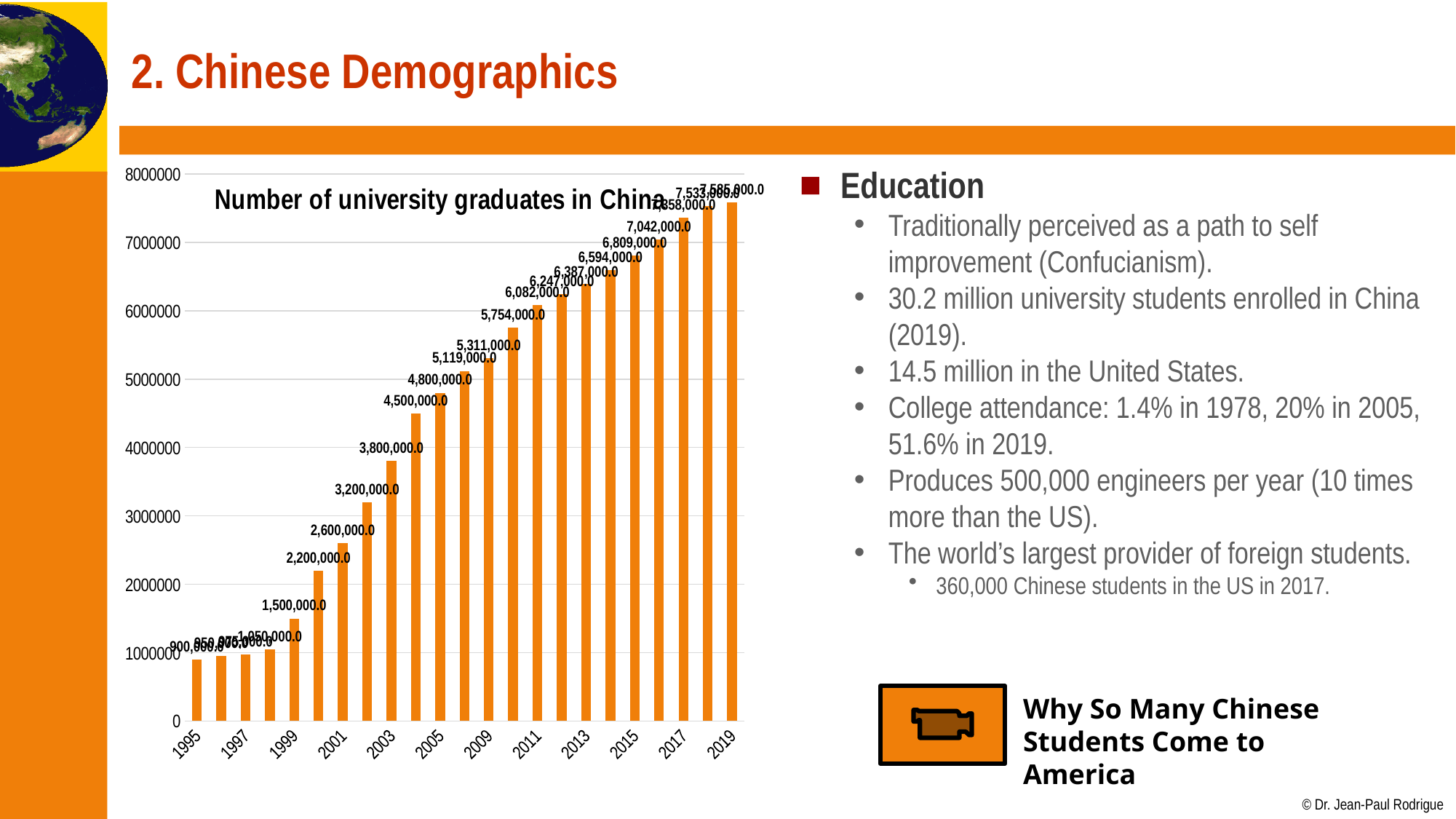
What is the number of university graduates in China in 2015? 6,809,000.0 Do the number of university graduates in China rise or fall from 1995 to 2019? rise Which year has the highest number of university graduates in China? 2019 Which year has more university graduates, 2011 or 2005? 2011 What is the number of university graduates in China in 2009? 5,311,000.0 What is the number of university graduates in China in 2003? 3,800,000.0 What kind of chart is used to show the number of university graduates in China? bar chart What is the title of the chart? Number of university graduates in China What is the number of university graduates in China in 2019? 7,585,000.0 What is the difference between the number of university graduates in 2019 and in 2015? 776,000.0 What is the number of university graduates in China in 1999? 1,500,000.0 Which year has the lowest number of university graduates in China? 1995